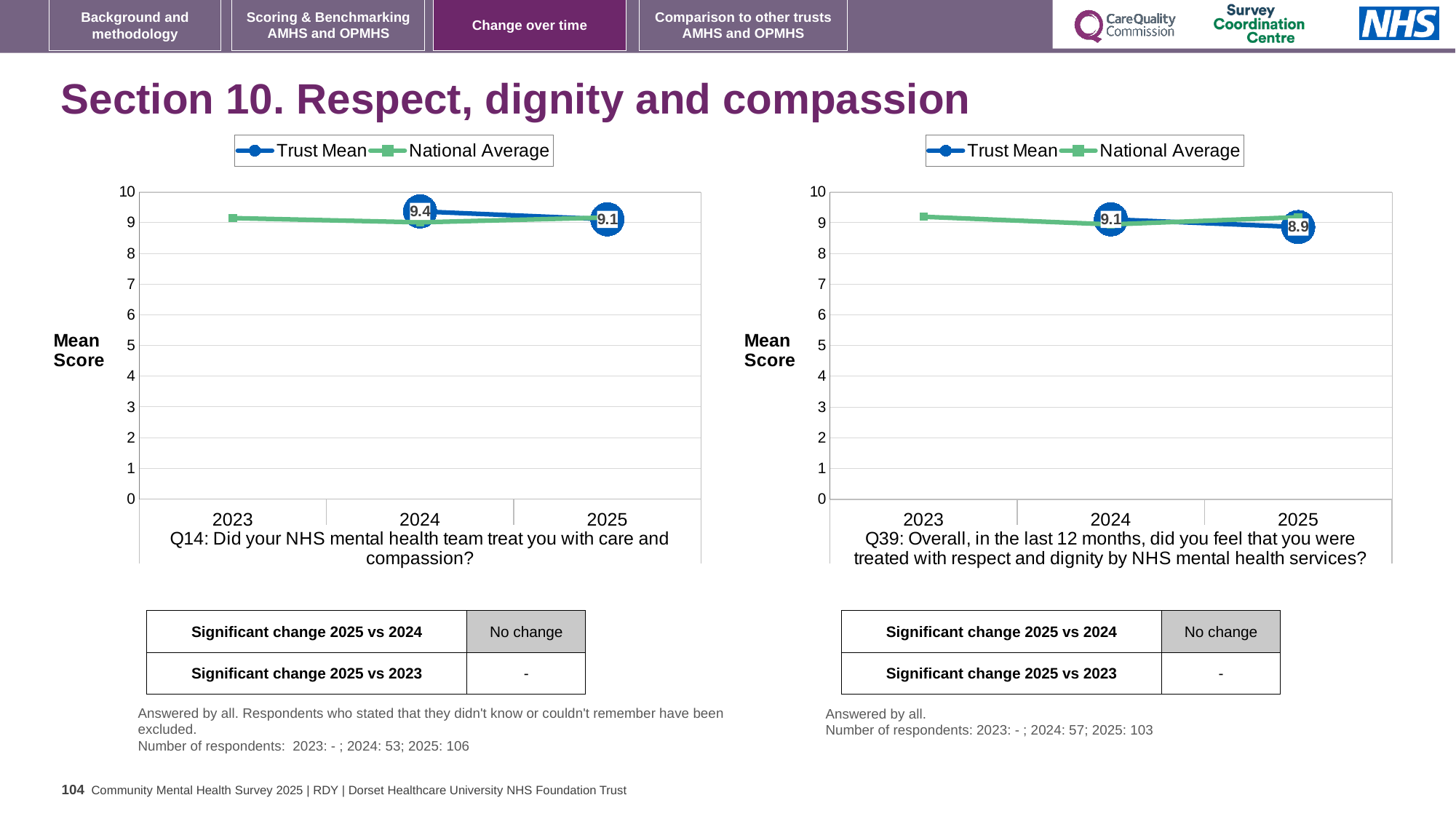
On the Q14 chart (left), what is the Trust Mean for 2025? 9.1 On the Q14 chart (left), does the Trust Mean rise or fall from 2024 to 2025? fall What kind of chart is the Q14 chart (left)? line chart On the Q39 chart (right), what is the Trust Mean for 2025? 8.9 On the Q14 chart (left), is the National Average for 2023 greater or less than 8? greater How many years are shown on the x axis of the Q39 chart (right)? 3 On the Q14 chart (left), what is the Trust Mean for 2024? 9.4 On the Q14 chart (left), by how much did the Trust Mean change from 2024 to 2025? 0.3 On the Q39 chart (right), what is the Trust Mean for 2024? 9.1 On the Q39 chart (right), what is the difference between the Trust Mean in 2024 and 2025? 0.2 On the Q39 chart (right), is the Trust Mean for 2025 greater or less than 9? less How many series does the legend of the Q39 chart (right) list? 2